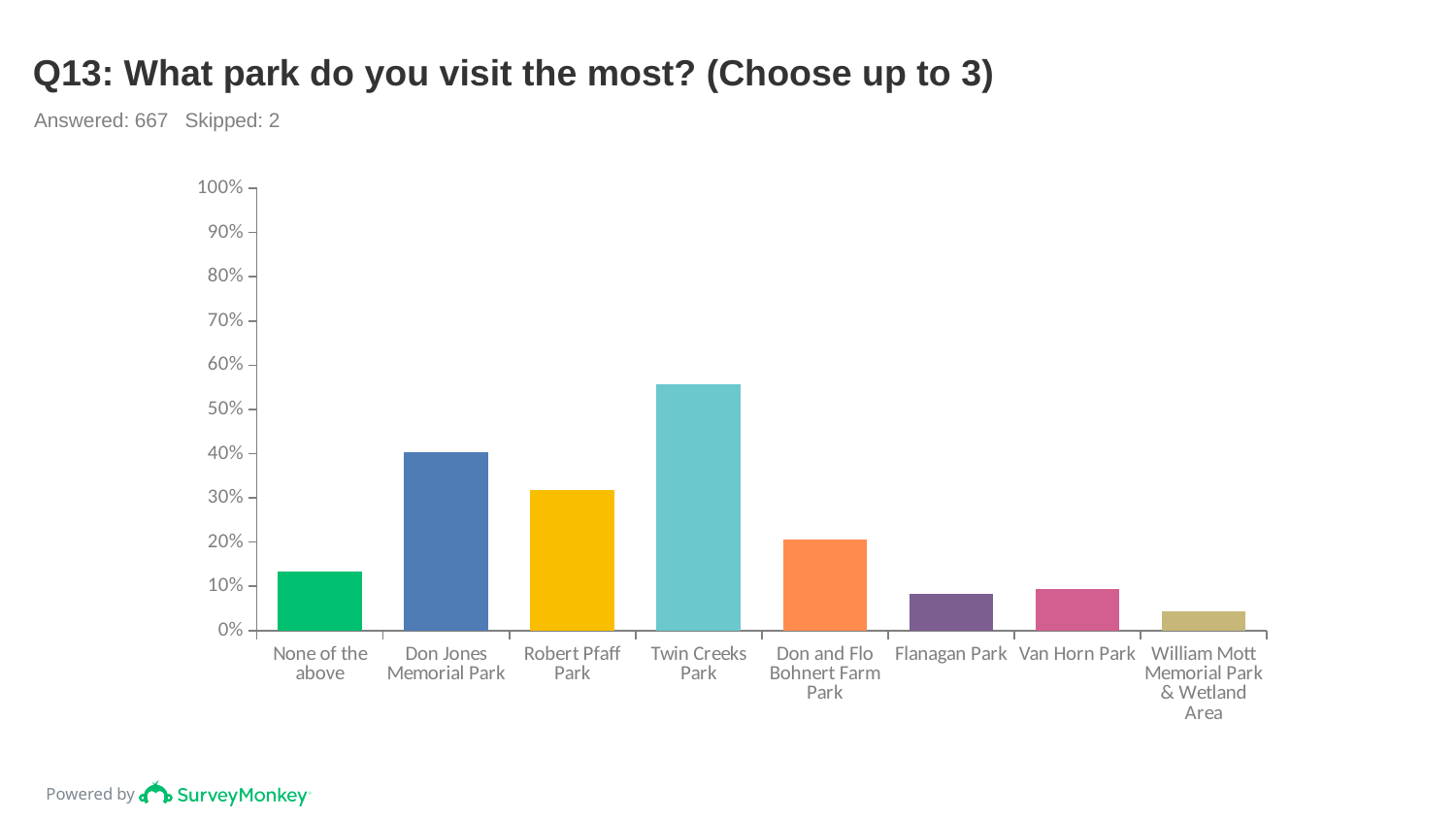
Is the value for Don and Flo Bohnert Farm Park greater or less than 30%? less How many respondents answered the question shown in the chart title? 667 How many park categories are shown on the x axis? 8 Is the value for Twin Creeks Park greater or less than 50%? greater What kind of chart is shown on the slide? bar chart Which category has the highest value? Twin Creeks Park Is the value for William Mott Memorial Park & Wetland Area greater or less than 10%? less Which category has the lowest value? William Mott Memorial Park & Wetland Area Which is larger, the value for Van Horn Park or the value for Don and Flo Bohnert Farm Park? Don and Flo Bohnert Farm Park Which is larger, the value for Don Jones Memorial Park or the value for Robert Pfaff Park? Don Jones Memorial Park